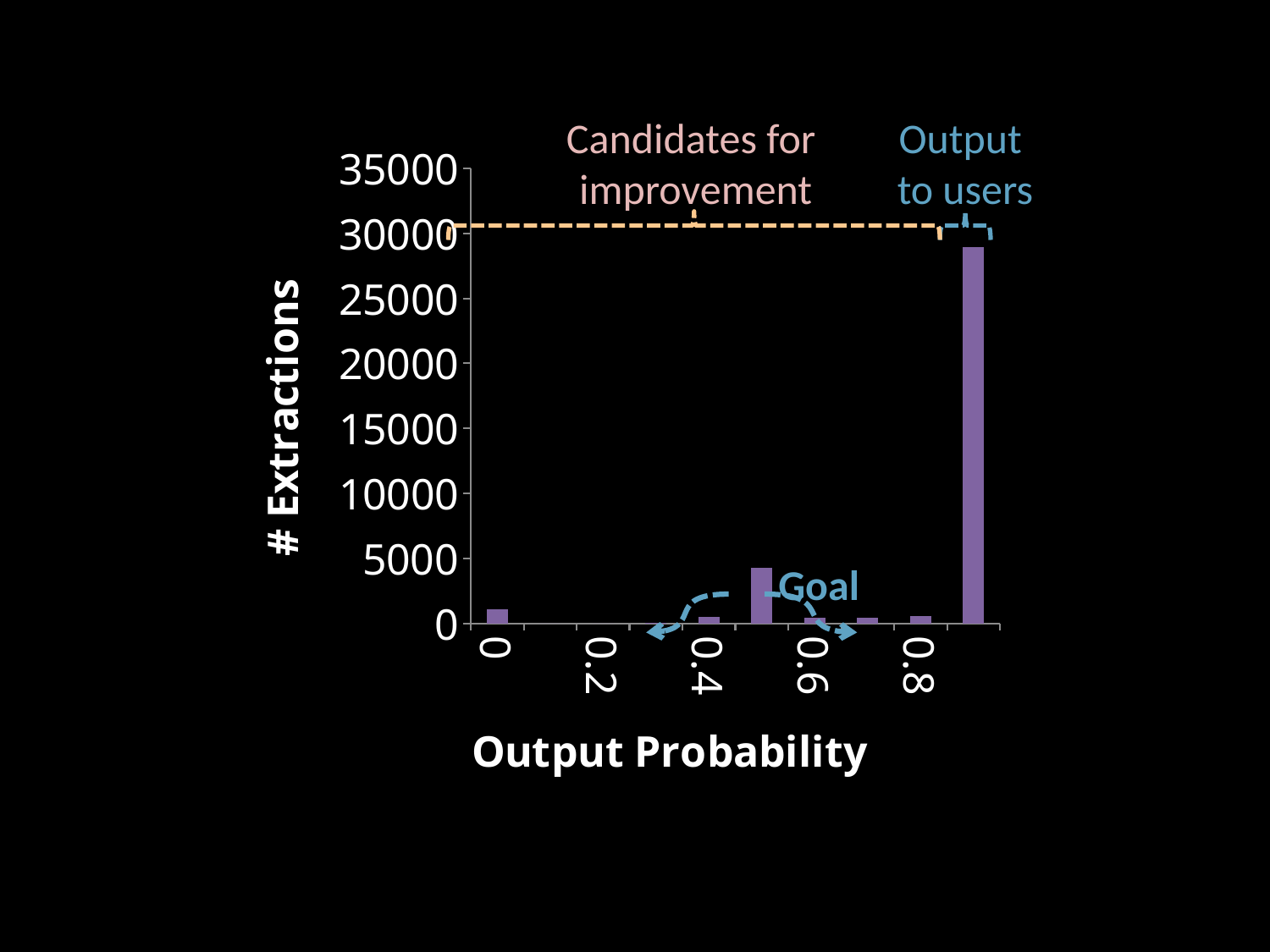
Which is larger: the bar at output probability 0.5 or the bar just right of 0.8? the bar just right of 0.8 What is the title of the x axis? Output Probability Is the value of the tallest bar greater or less than 25000? greater Is the value of the tallest bar greater or less than 20000? greater What kind of chart is shown on the slide? bar chart Is the tallest bar located to the left or to the right of the 0.8 tick on the x axis? right Is the value of the bar at output probability 0.5 greater or less than 5000? less What is the title of the y axis? # Extractions Which is larger: the bar at output probability 0 or the bar at output probability 0.5? the bar at 0.5